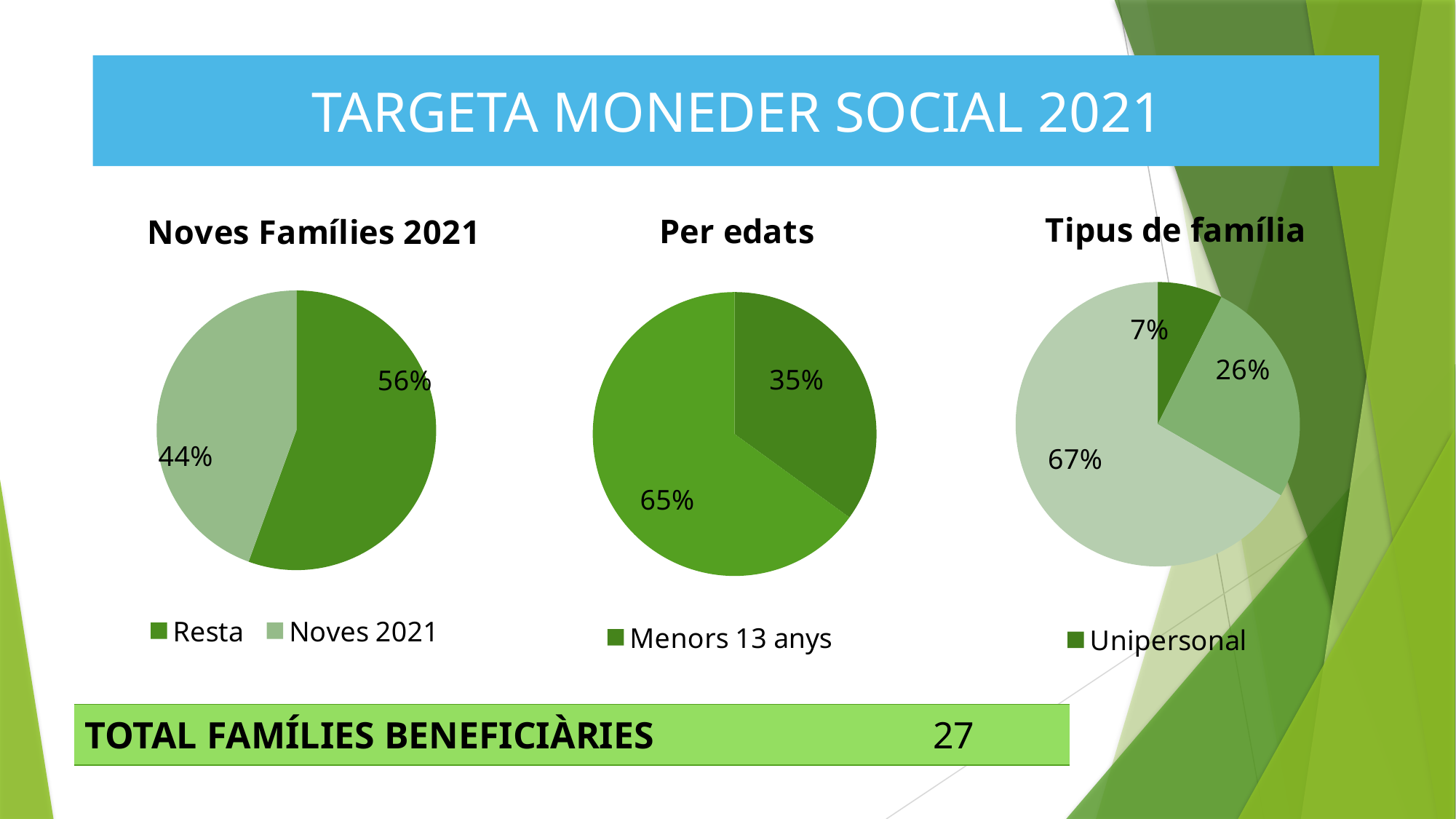
In the 'Tipus de família' chart, what percentage is shown for Unipersonal? 7% How many entries does the legend of the 'Noves Famílies 2021' chart list? 2 What is the title of the middle chart on the slide? Per edats In the 'Tipus de família' chart, what is the smallest percentage shown? 7% In the 'Noves Famílies 2021' chart, which is larger, Resta or Noves 2021? Resta In the 'Noves Famílies 2021' chart, what is the difference in percentage points between Resta and Noves 2021? 12 What type of chart is the 'Per edats' chart? Pie chart In the 'Per edats' chart, what percentage is shown for Menors 13 anys? 35% In the 'Noves Famílies 2021' chart, what percentage is shown for Noves 2021? 44% How many slices does the 'Tipus de família' chart have? 3 In the 'Noves Famílies 2021' chart, which category has the largest share? Resta In the 'Noves Famílies 2021' chart, what percentage is shown for Resta? 56%